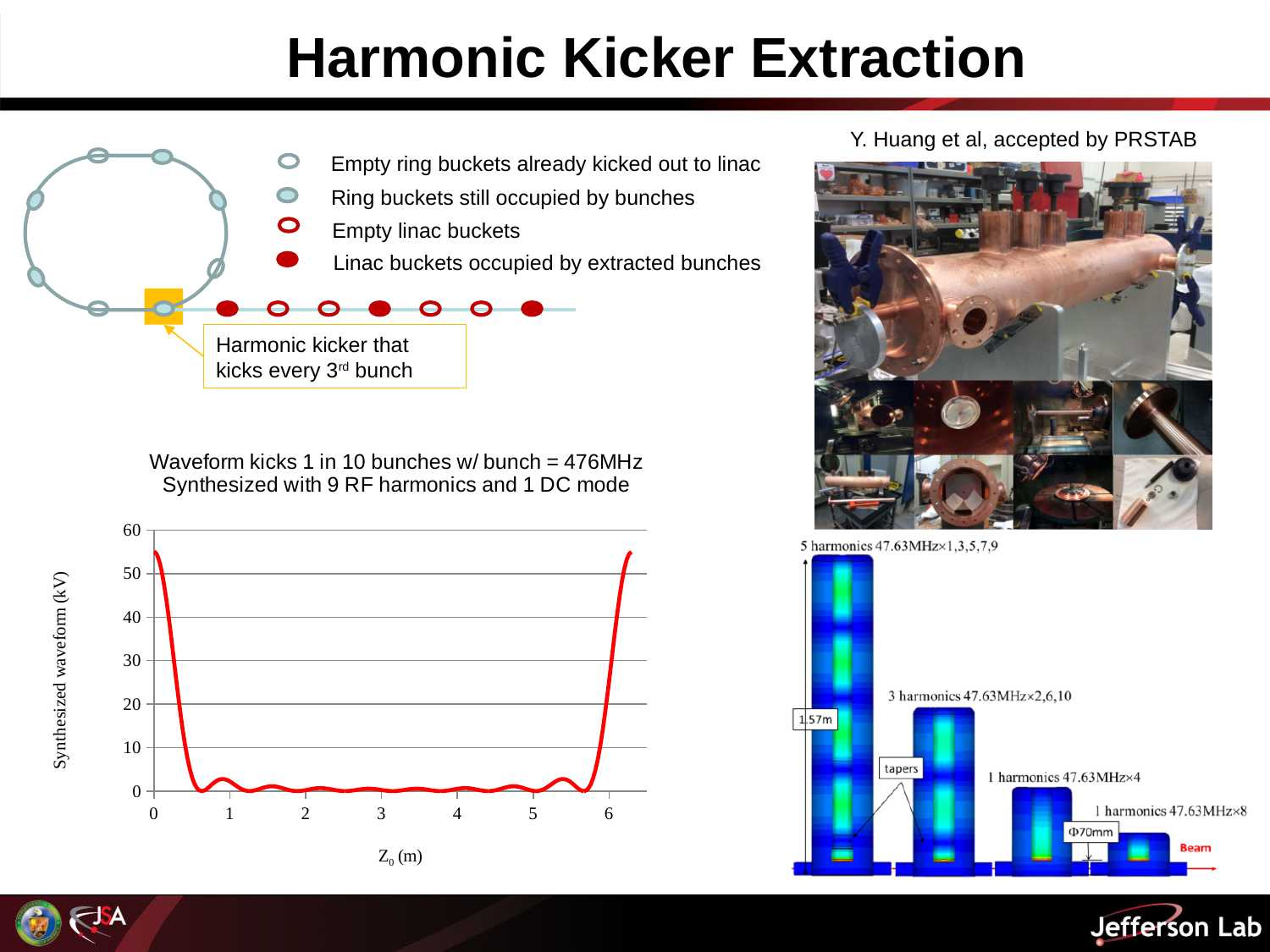
In the synthesized waveform chart, is the value at Z0 = 0 greater or less than 50? greater In the synthesized waveform chart, does the waveform rise or fall between Z0 = 0 and Z0 = 0.5? fall What is the highest tick value shown on the y axis of the synthesized waveform chart? 60 In the synthesized waveform chart, which is larger: the value at Z0 = 0 or the value at Z0 = 3? Z0 = 0 In the synthesized waveform chart, is the value at Z0 = 5 greater or less than 20? less What kind of chart is shown at the bottom left of the slide? line chart In the synthesized waveform chart, is the value at Z0 = 3 greater or less than 10? less In the synthesized waveform chart, does the waveform rise or fall between Z0 = 5.8 and Z0 = 6.2? rise What is the label of the x axis of the synthesized waveform chart? Z0 (m) What is the label of the y axis of the synthesized waveform chart? Synthesized waveform (kV)